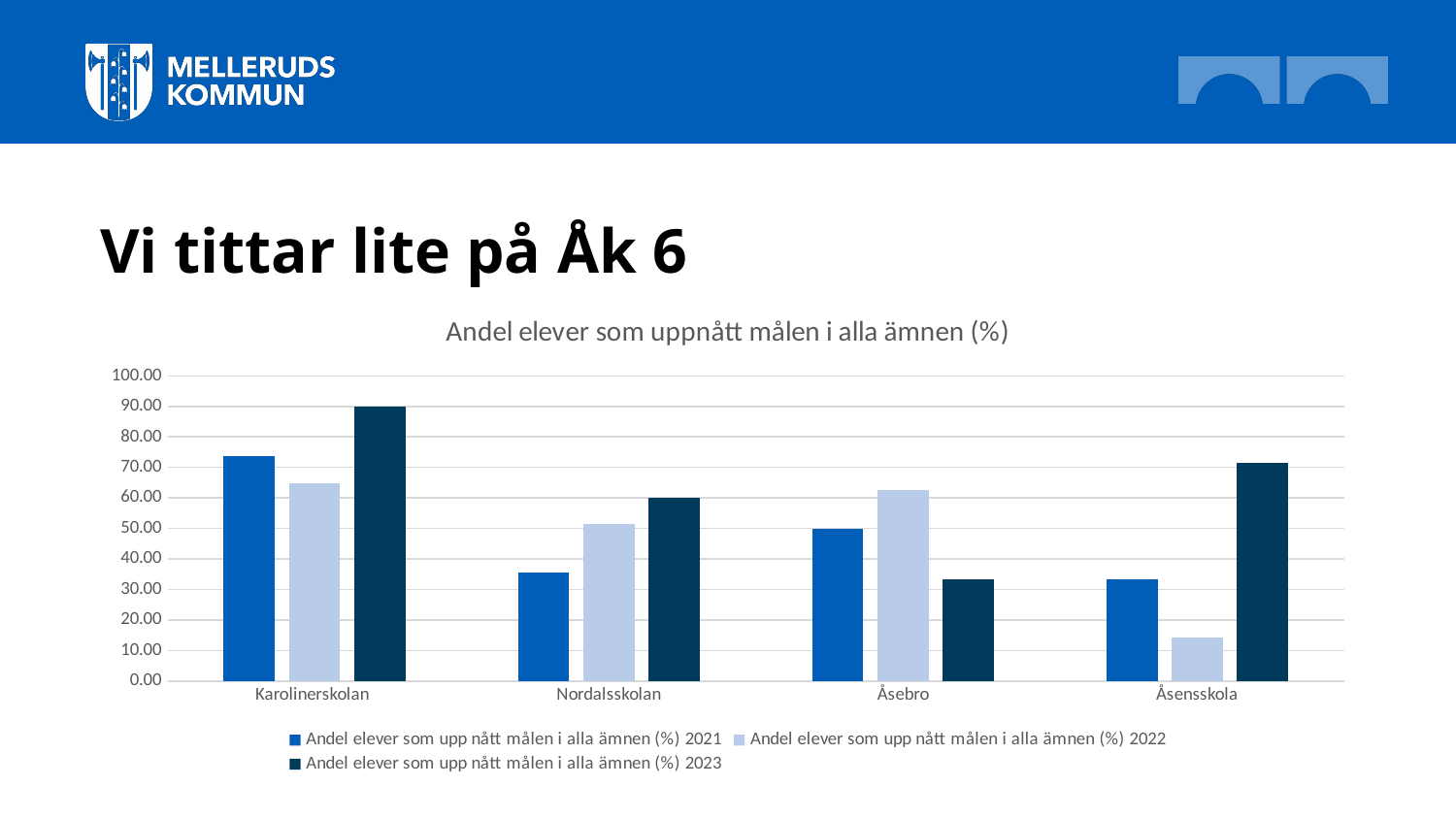
Which school has the highest bar for 2023 in the chart? Karolinerskolan For Nordalsskolan, do the values rise or fall from 2021 to 2023? rise What is the title of the chart? Andel elever som uppnått målen i alla ämnen (%) What kind of chart is shown on the slide? bar chart Which school has the lowest bar for 2023 in the chart? Åsebro Which school has the highest bar for 2021 in the chart? Karolinerskolan Which school has the lowest bar for 2022 in the chart? Åsensskola Is the 2021 value for Nordalsskolan greater or less than 40? less How many schools (categories) are shown on the x axis of the chart? 4 Is the 2022 value for Åsensskola greater or less than 20? less How many series does the chart legend list? 3 Is the 2023 value for Karolinerskolan greater or less than 80? greater